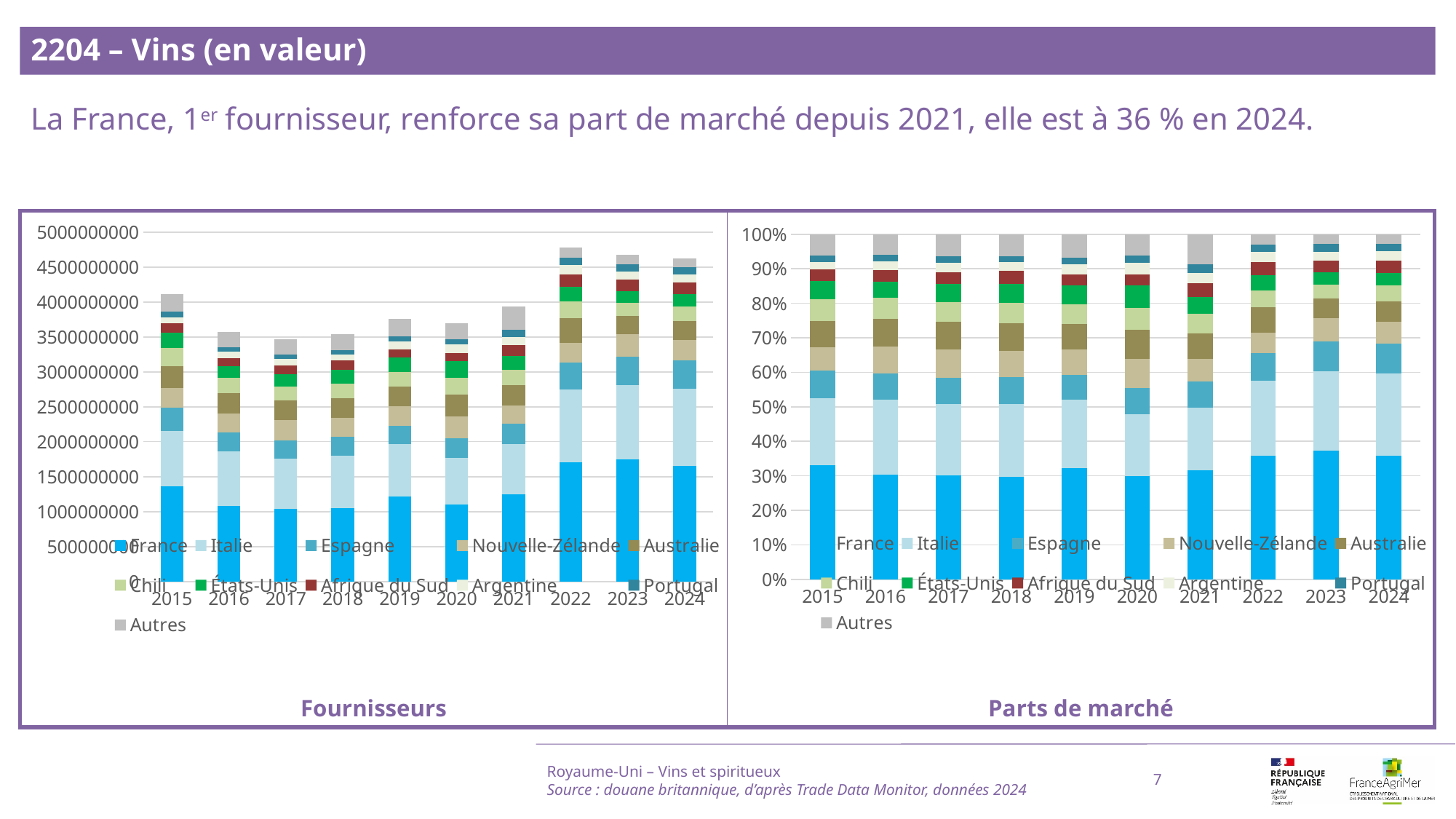
How many series does the legend of the 'Fournisseurs' chart list? 11 In the 'Parts de marché' chart, does France's share rise or fall from 2021 to 2024? rise How many years are shown on the x axis of the 'Parts de marché' chart? 10 Which series is listed first in the legend of the 'Parts de marché' chart? France In the 'Fournisseurs' chart, is the total value for 2022 greater or less than 4500000000? greater In the 'Fournisseurs' chart, is the France segment for 2023 greater or less than 1500000000? greater In the 'Fournisseurs' chart, is the France segment for 2015 greater or less than 1000000000? greater What kind of chart is the 'Fournisseurs' chart on the left? Stacked bar chart In the 'Fournisseurs' chart, which year has the highest total bar? 2022 In the 'Fournisseurs' chart, is the France segment larger in 2022 or in 2015? 2022 In the 'Parts de marché' chart, is France's share larger in 2023 or in 2015? 2023